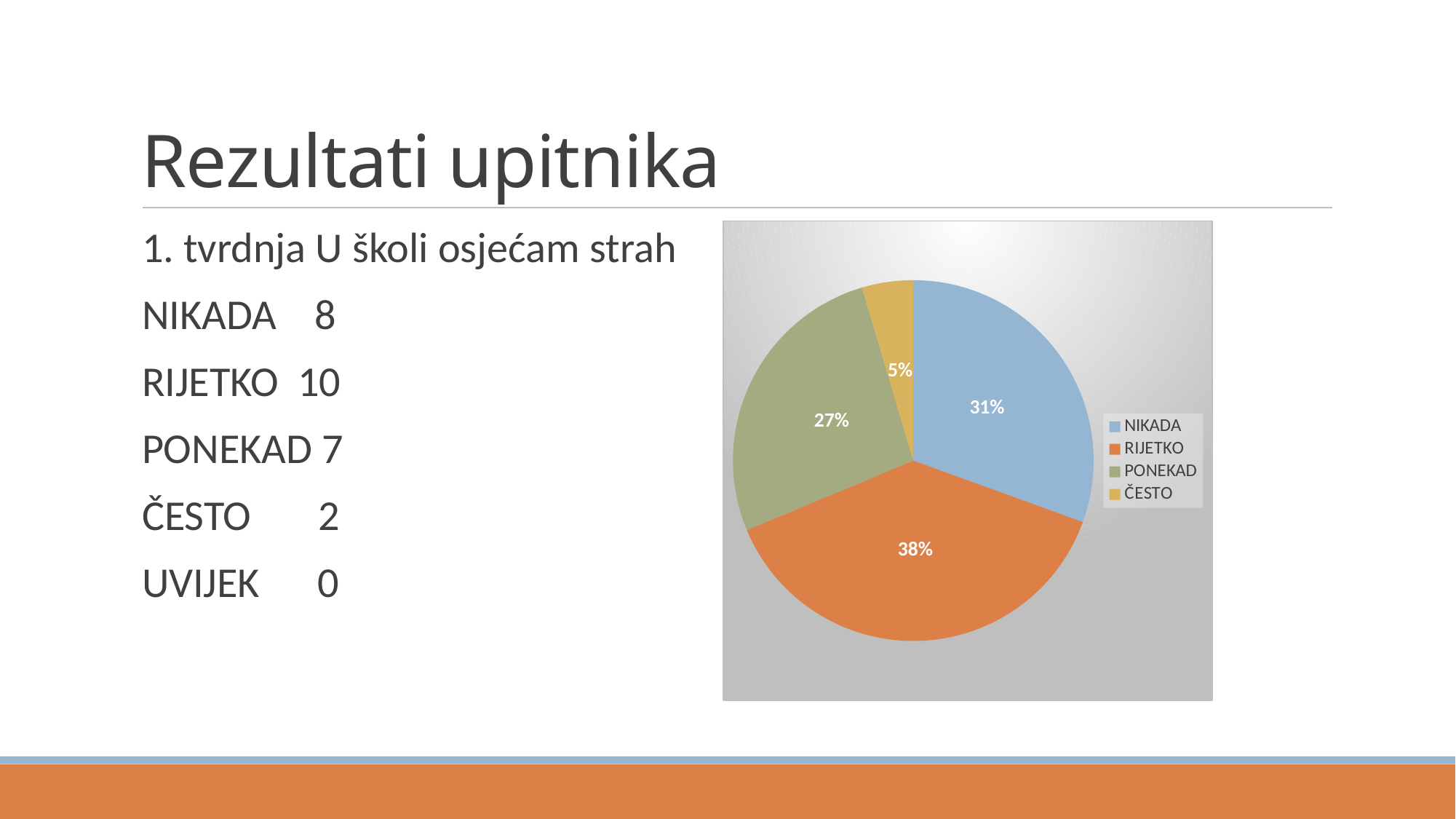
What percentage of the pie does the RIJETKO slice represent? 38% What colour is the RIJETKO slice in the pie chart? orange What percentage of the pie does the NIKADA slice represent? 31% What percentage of the pie does the PONEKAD slice represent? 27% Which category has the largest slice of the pie? RIJETKO How many slices does the pie chart have? 4 Which category has the smallest slice of the pie? ČESTO What kind of chart is shown on the slide? pie chart Which slice is larger, NIKADA or PONEKAD? NIKADA What is the difference in percentage points between the RIJETKO and ČESTO slices? 33 What percentage of the pie does the ČESTO slice represent? 5% How many entries does the legend list? 4